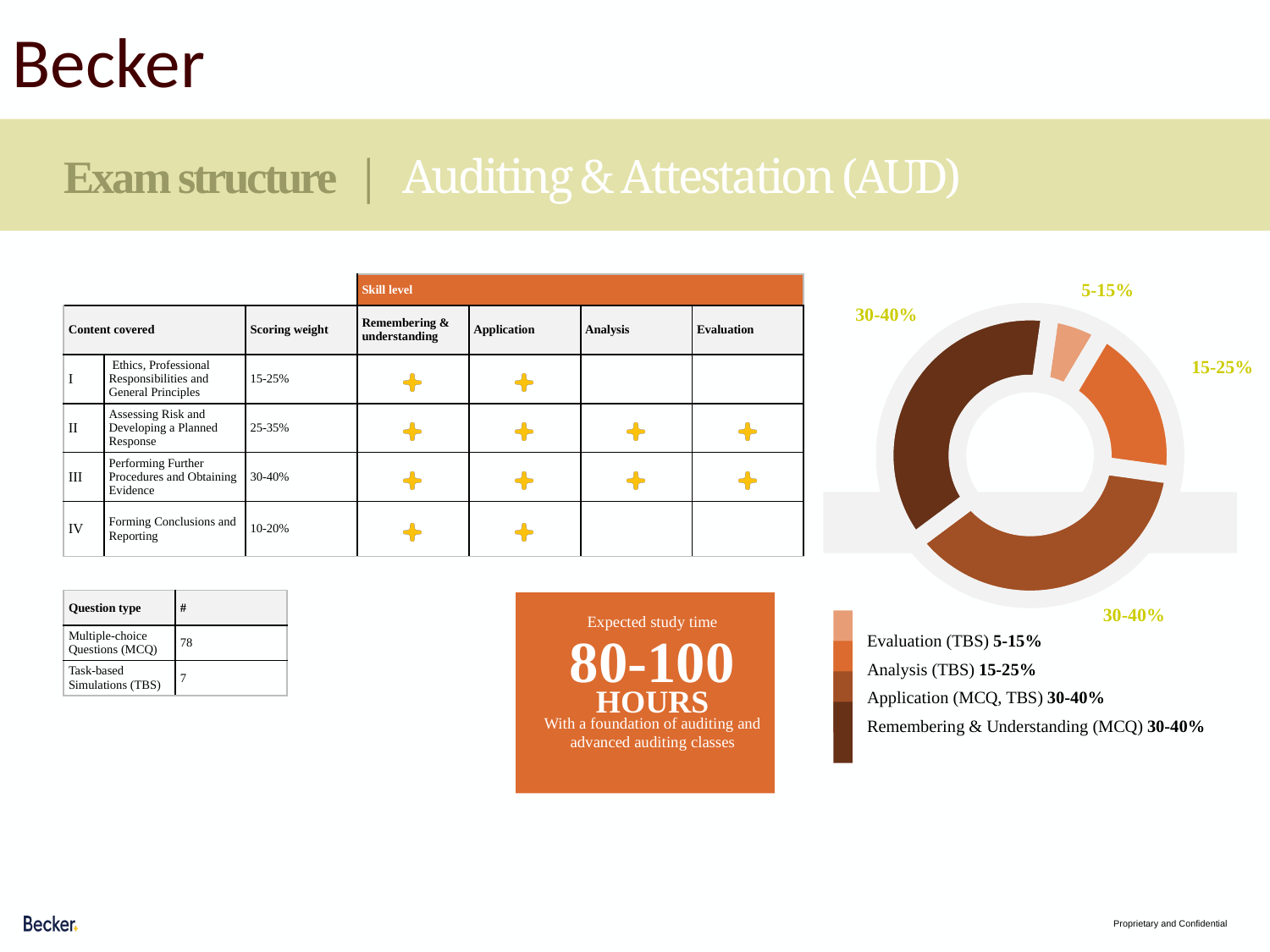
Which legend entry of the donut chart is shown in the lightest colour? Evaluation (TBS) What kind of chart is shown on the right side of the slide? Pie chart (donut) How many entries does the legend of the donut chart list? 4 Which slice is larger in the donut chart, Analysis (TBS) or Evaluation (TBS)? Analysis (TBS) What share does the donut chart show for Application (MCQ, TBS)? 30-40% What share does the donut chart show for Remembering & Understanding (MCQ)? 30-40% What share does the donut chart show for Analysis (TBS)? 15-25% What share does the donut chart show for Evaluation (TBS)? 5-15% Which skill level has the smallest slice in the donut chart? Evaluation (TBS) Which two skill levels share the same 30-40% weighting in the donut chart? Application (MCQ, TBS) and Remembering & Understanding (MCQ) How many slices does the donut chart have? 4